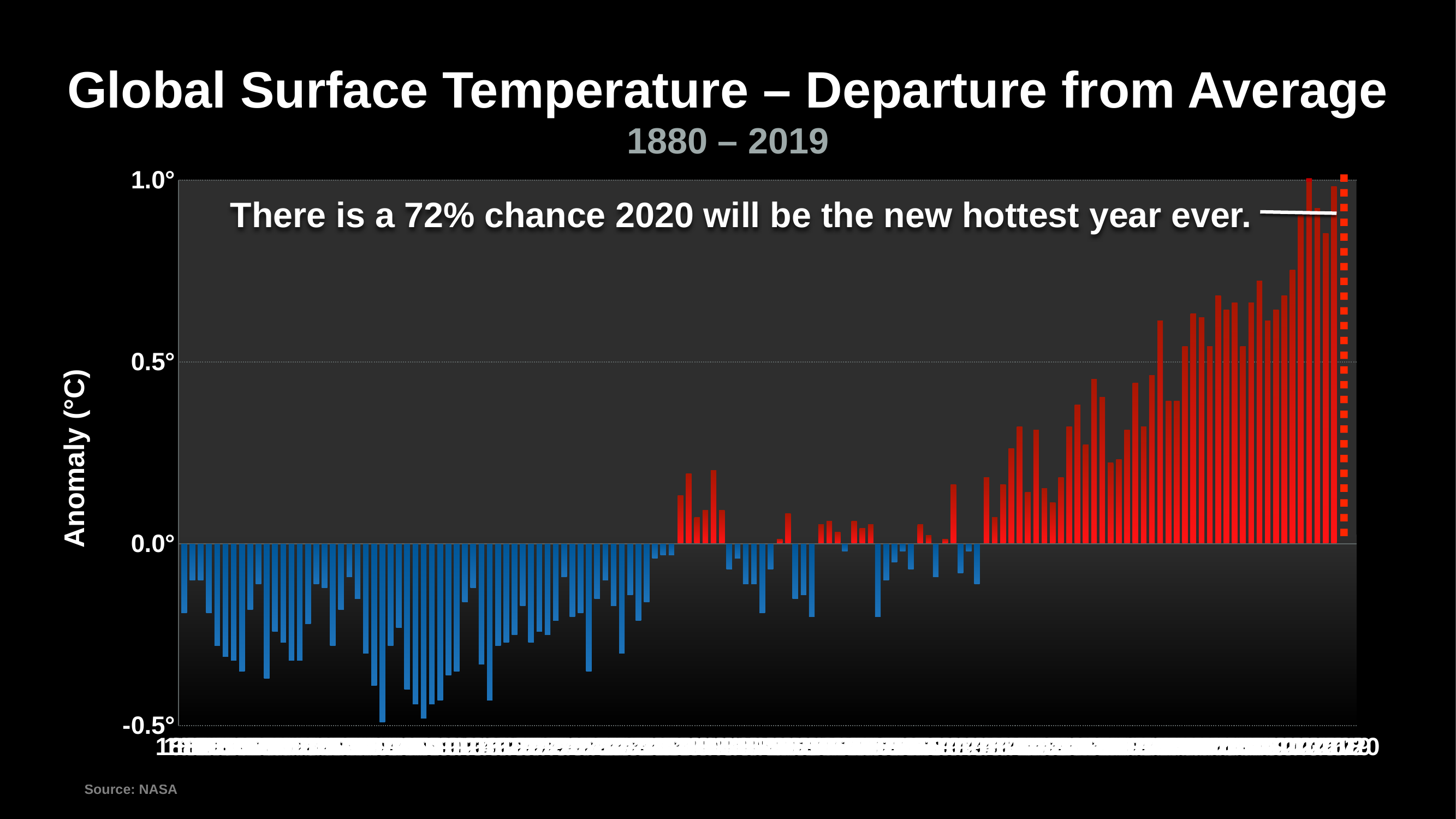
What is the title of the chart? Global Surface Temperature – Departure from Average Is the tallest bar on the chart greater or less than 0.5°? greater Do the temperature anomaly values generally rise or fall from left to right along the x axis? rise Is the lowest bar on the chart greater or less than 0.0°? less Are the bars at the right end of the chart higher or lower than the bars at the left end? higher According to the annotation on the chart, what is the chance that 2020 will be the new hottest year ever? 72% What kind of chart is shown on the slide? bar chart